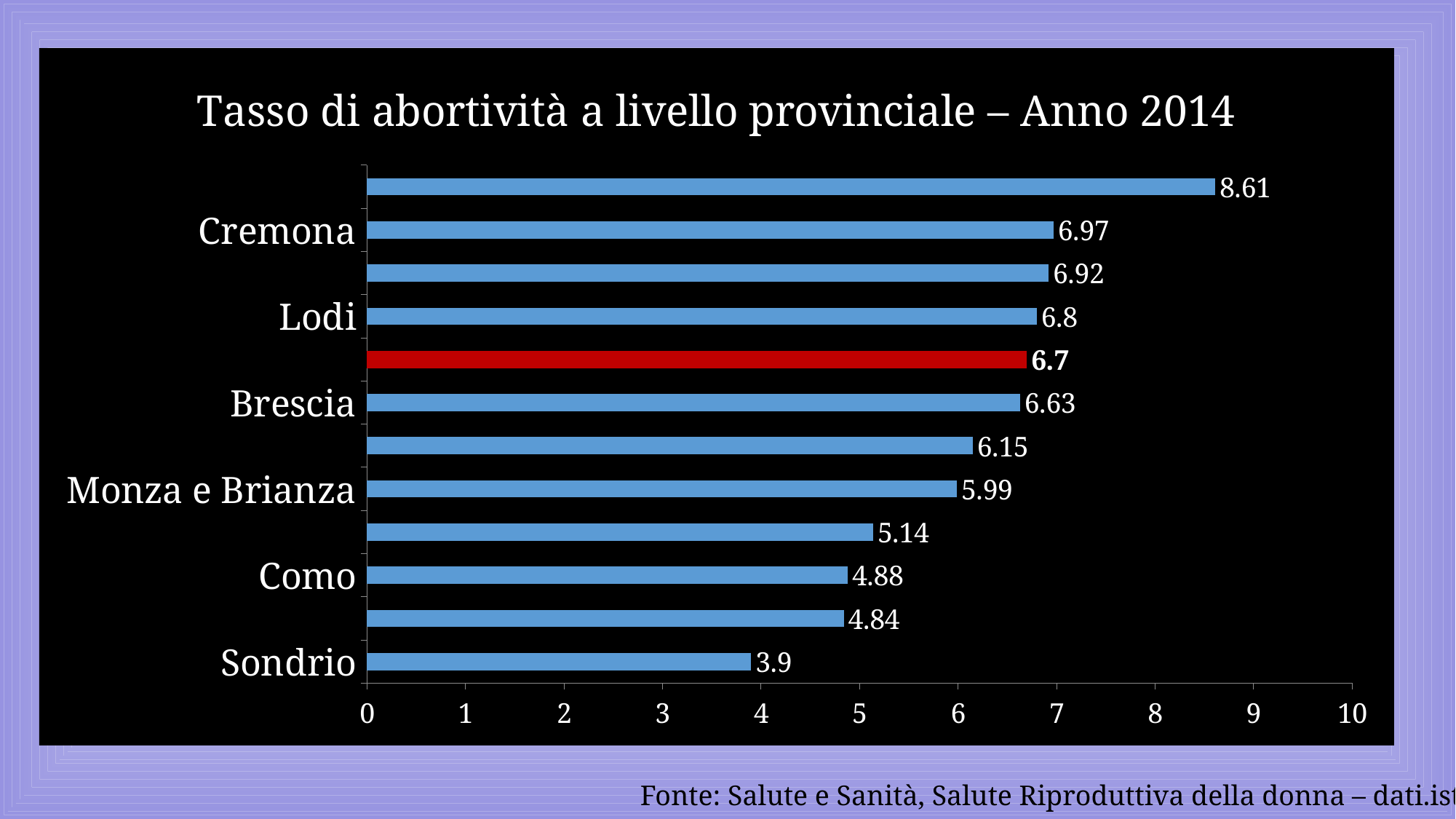
Which province has the lowest value? Sondrio What is the difference between the values for Cremona and Sondrio? 3.07 What is the value for Cremona? 6.97 What is the value for Brescia? 6.63 What is the value for Lodi? 6.8 What is the value for Como? 4.88 What value is shown on the red bar? 6.7 What is the value for Sondrio? 3.9 Which has a higher value, Lodi or Brescia? Lodi What is the largest value shown on the chart? 8.61 How many bars are plotted on the chart? 12 What is the value for Monza e Brianza? 5.99